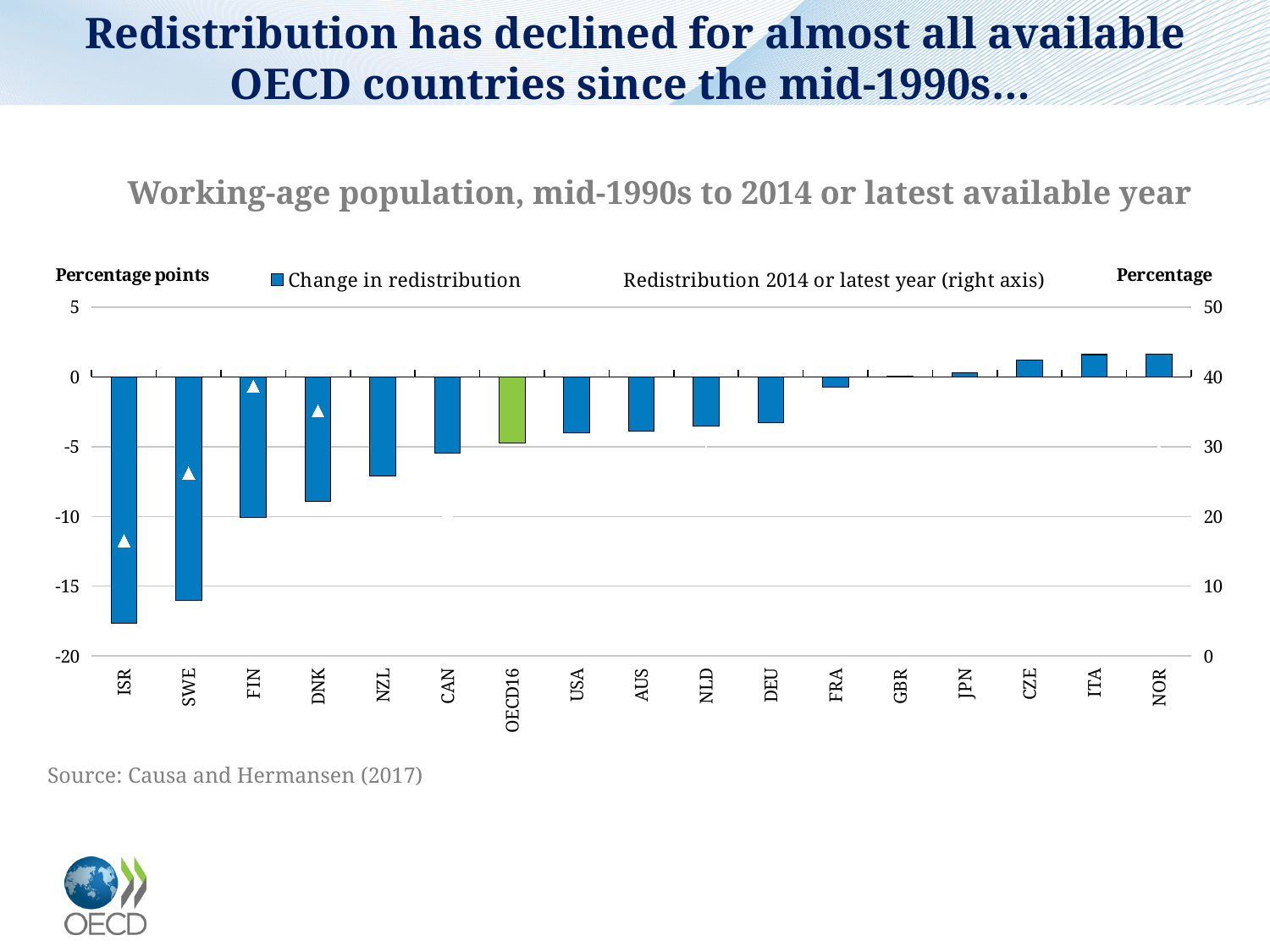
What kind of chart is shown on the slide? bar chart How many countries or groups are shown along the x axis of the chart? 17 Is the change in redistribution for FIN greater or less than -5? less Which has a larger change in redistribution, FIN or NZL? NZL Which category's bar is coloured green rather than blue? OECD16 What is the label of the left vertical axis of the chart? Percentage points Which country has the lowest change in redistribution? ISR How many series does the chart's legend list? 2 Is the change in redistribution for NZL greater or less than -10? greater Is the change in redistribution for USA greater or less than -5? greater Do the change in redistribution values rise or fall moving from left to right along the x axis? rise